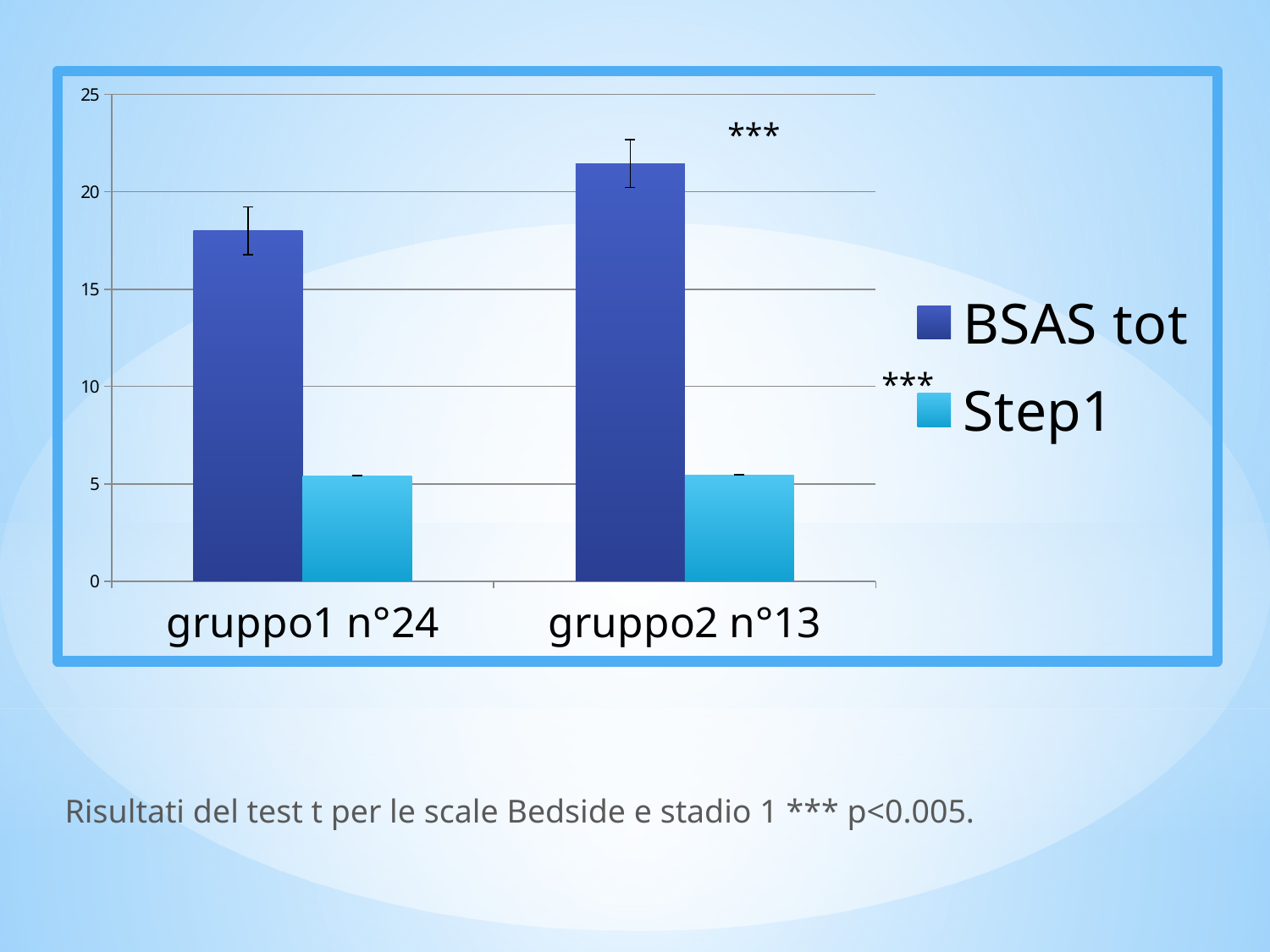
Is the BSAS tot value for gruppo1 n°24 greater or less than 15? greater How many series does the chart's legend list? 2 Which category has the higher BSAS tot value, gruppo1 n°24 or gruppo2 n°13? gruppo2 n°13 Which category has the highest BSAS tot value? gruppo2 n°13 What are the two series listed in the chart's legend? BSAS tot and Step1 How many categories are shown on the x axis of the chart? 2 Is the BSAS tot value for gruppo1 n°24 greater or less than 20? less Is the Step1 value for gruppo1 n°24 greater or less than 10? less Which series is drawn in the lighter blue colour? Step1 What kind of chart is shown on the slide? bar chart For gruppo2 n°13, which series has the larger value, BSAS tot or Step1? BSAS tot